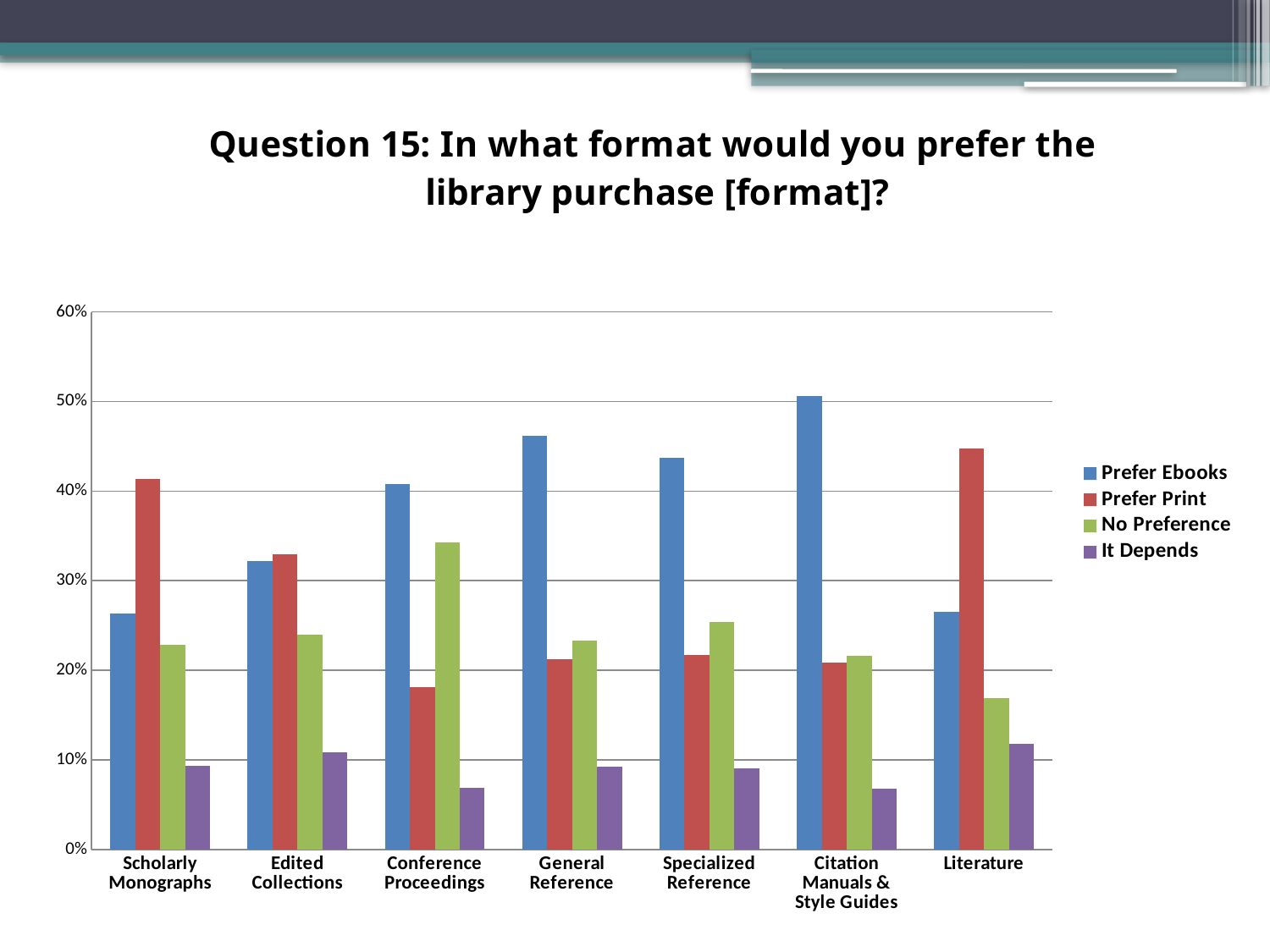
How many categories are shown along the x axis? 7 Which series is shown in green in the legend? No Preference Which category has the highest value for No Preference? Conference Proceedings Which category has the lowest value for Prefer Print? Conference Proceedings Is the value for Prefer Print in Literature greater or less than 40%? greater Which category has the highest value for Prefer Print? Literature Which category has the highest value for Prefer Ebooks? Citation Manuals & Style Guides Is the value for Prefer Print in Conference Proceedings greater or less than 20%? less How many series does the legend list? 4 What kind of chart is shown on the slide? Bar chart Is the value for Prefer Ebooks in Scholarly Monographs greater or less than 30%? less For Scholarly Monographs, which is larger: Prefer Ebooks or Prefer Print? Prefer Print